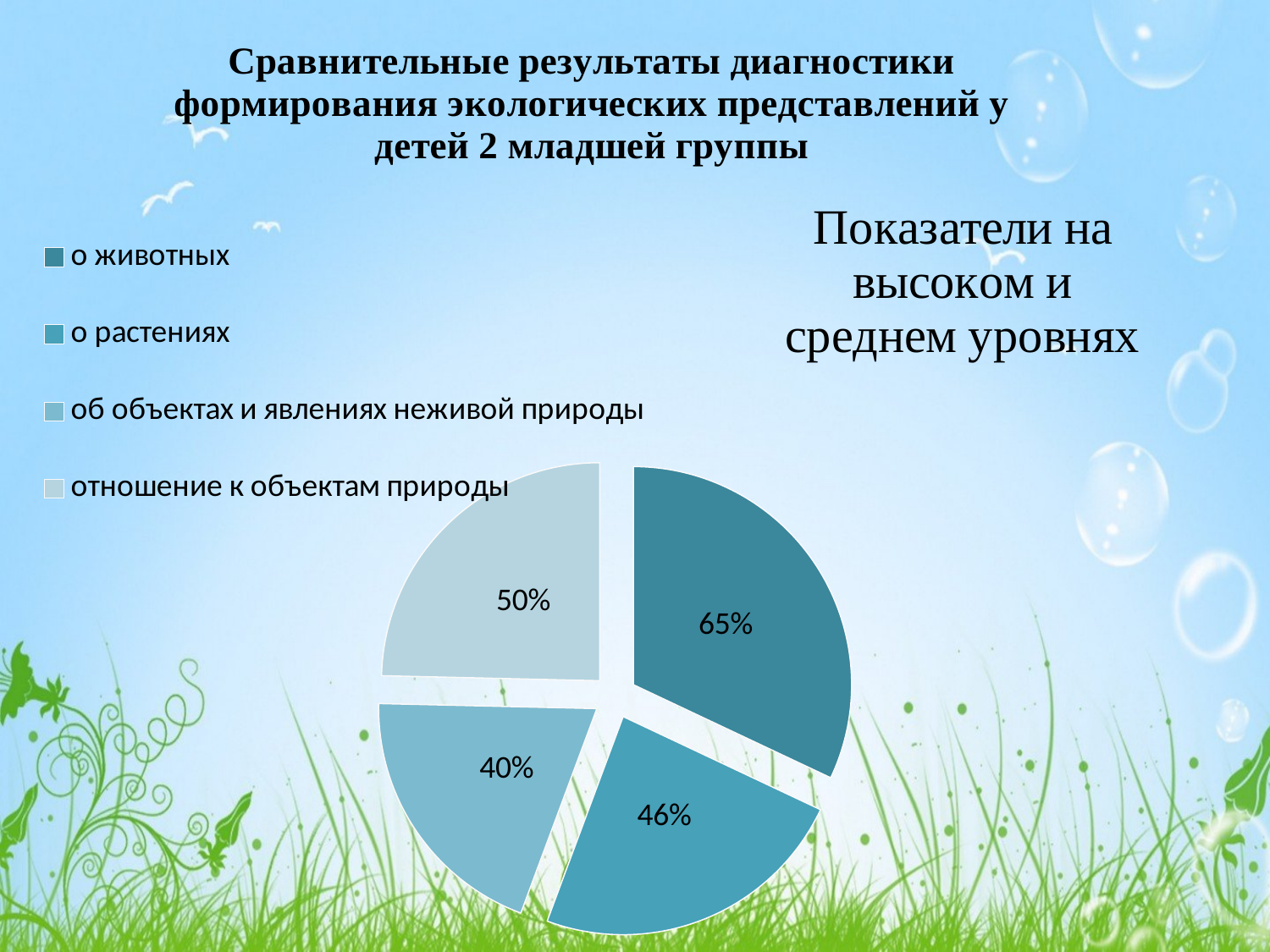
What is the difference between the values for "отношение к объектам природы" and "об объектах и явлениях неживой природы"? 10% Which category has the lowest value in the pie chart? об объектах и явлениях неживой природы What value is shown for the slice "отношение к объектам природы"? 50% How many slices does the pie chart have? 4 What value is shown for the slice "о растениях"? 46% Which category has the highest value in the pie chart? о животных What kind of chart is shown on the slide? pie chart What value is shown for the slice "об объектах и явлениях неживой природы"? 40% Which is larger, the value for "о растениях" or the value for "отношение к объектам природы"? отношение к объектам природы What value is shown for the slice "о животных"? 65% What is the difference between the values for "о животных" and "о растениях"? 19% Which legend entry is shown with the darkest colour? о животных